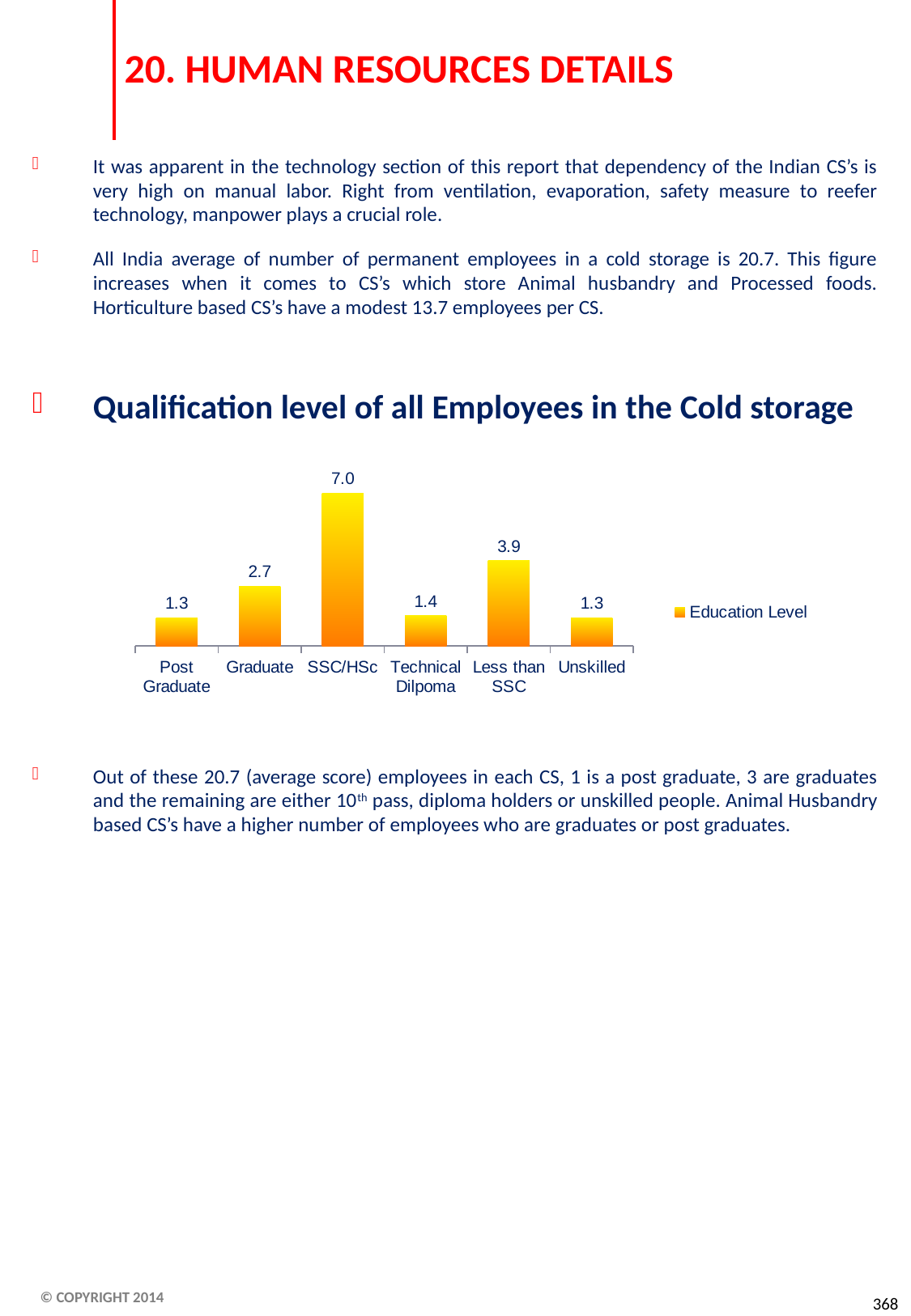
What is the value for Less than SSC? 3.9 What is the difference between the values for SSC/HSc and Less than SSC? 3.1 How many categories are shown on the x axis? 6 What is the value for SSC/HSc? 7.0 How many series does the legend list? 1 Which category has the highest value? SSC/HSc What is the value for Graduate? 2.7 What is the legend entry for the series? Education Level What is the difference between the values for Graduate and Post Graduate? 1.4 What is the value for Technical Dilpoma? 1.4 What kind of chart is shown? Bar chart Which is larger, the value for Graduate or the value for Less than SSC? Less than SSC